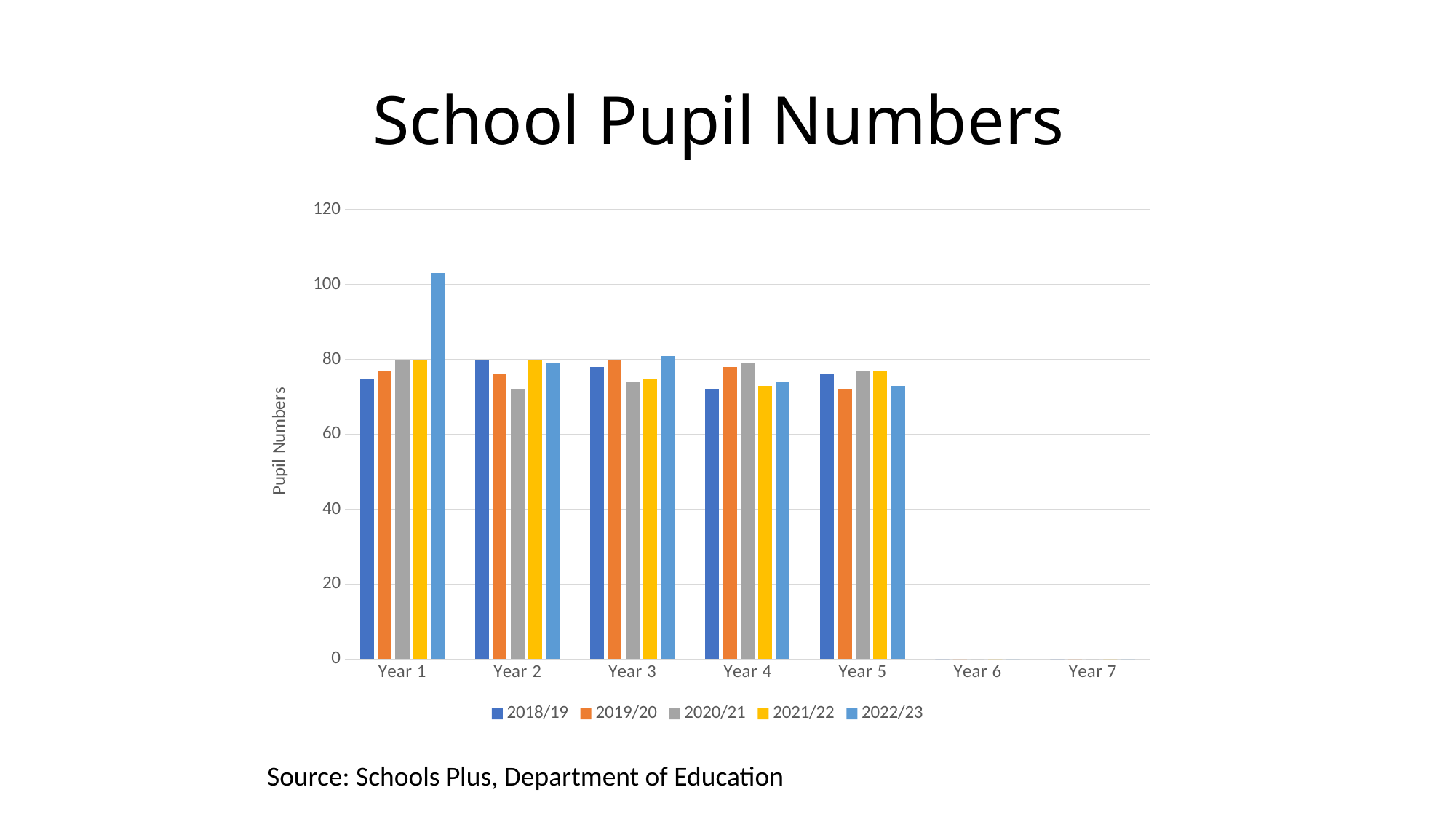
Which is larger in Year 1: the value for 2018/19 or the value for 2022/23? 2022/23 Which series has the highest value in Year 1? 2022/23 Is the value for 2018/19 in Year 4 greater or less than 80? less How many series does the legend list? 5 What is the label on the vertical axis? Pupil Numbers What kind of chart is shown on the slide? Bar chart Which is larger in Year 2: the value for 2018/19 or the value for 2020/21? 2018/19 Which series has the lowest value in Year 2? 2020/21 How many categories are labelled on the x axis? 7 Is the value for 2022/23 in Year 1 greater or less than 100? greater Is the value for 2020/21 in Year 2 greater or less than 80? less What is the title of the chart? School Pupil Numbers